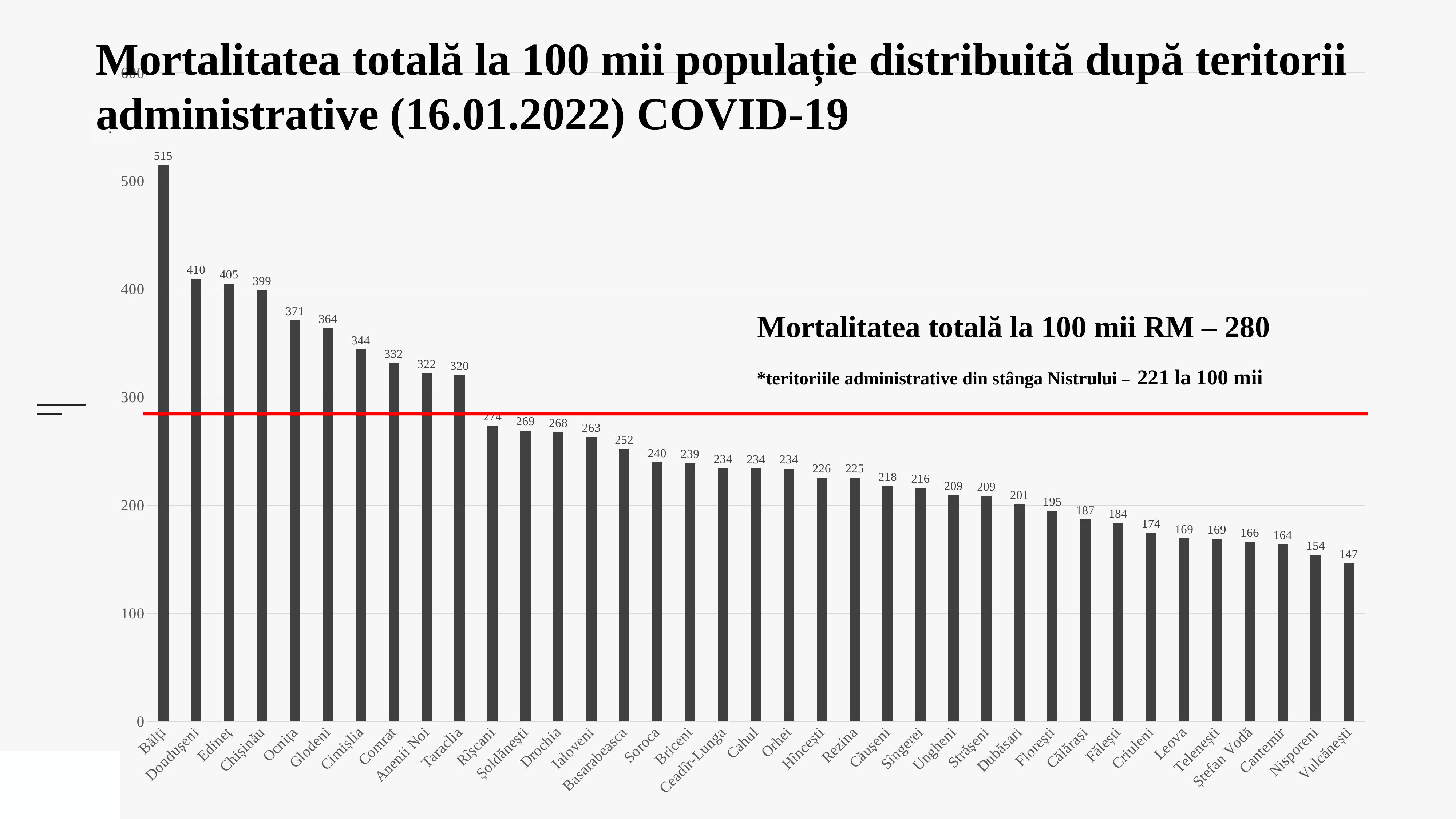
Which has a larger value, Ocnița or Glodeni? Ocnița What is the value for Nisporeni? 154 Which territory has the highest value? Bălți What is the value for Chișinău? 399 What kind of chart is shown on the slide? bar chart How many territories are shown on the chart? 37 Is the value for Taraclia greater or less than 300? greater What is the value for Bălți? 515 What is the value for Cahul? 234 Do the values rise or fall from left to right along the x axis? fall What is the difference between the values for Bălți and Dondușeni? 105 Which territory has the lowest value? Vulcănești